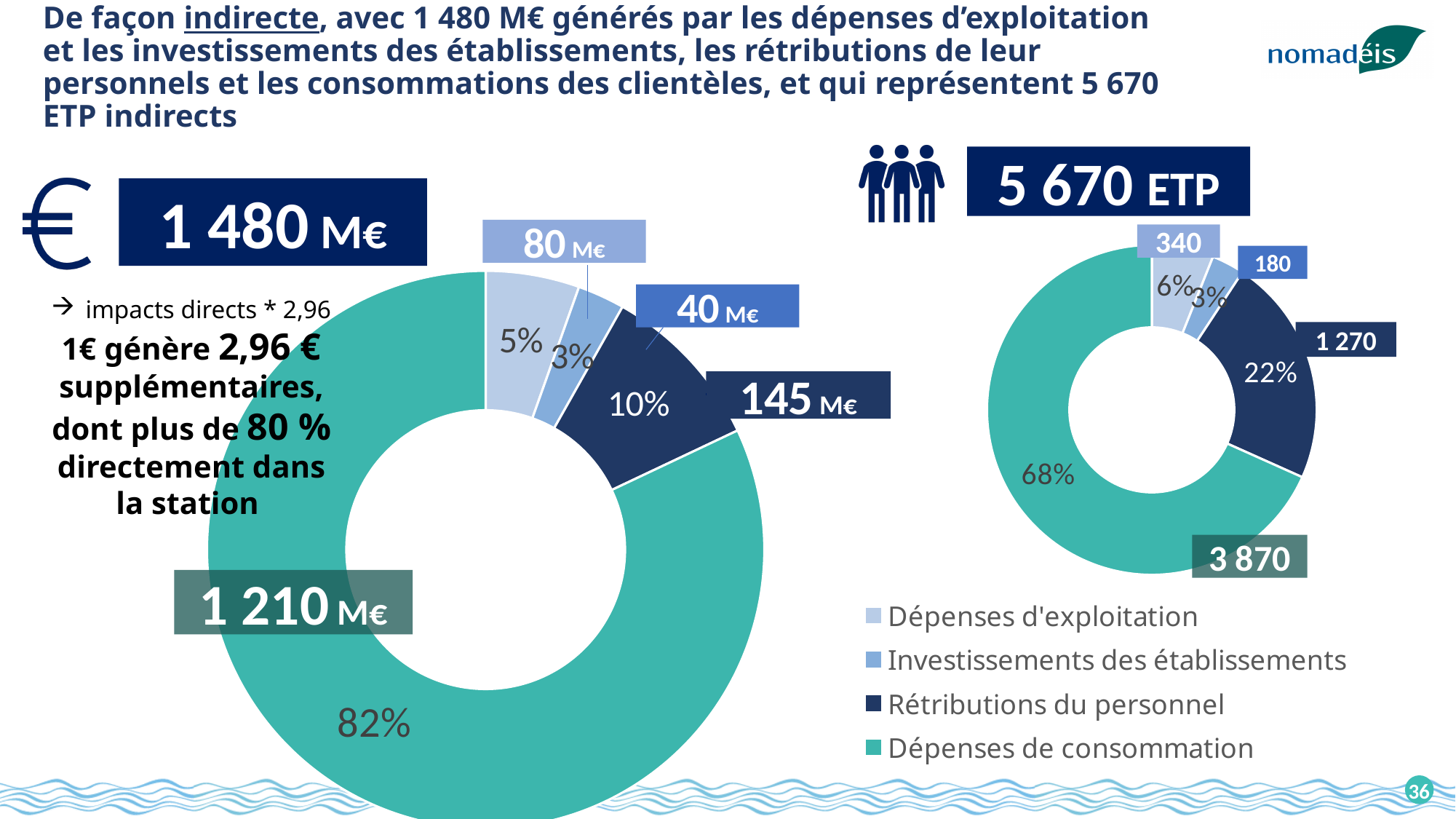
How many categories does the legend list for the donut charts? 4 In the right donut chart (5 670 ETP), which is larger: Investissements des établissements or Dépenses d'exploitation? Dépenses d'exploitation In the right donut chart (5 670 ETP), which category has the largest value? Dépenses de consommation In the left donut chart (1 480 M€), what is the difference between Rétributions du personnel and Dépenses d'exploitation? 65 M€ In the left donut chart (1 480 M€), what is the value for Rétributions du personnel? 145 M€ In the left donut chart (1 480 M€), which category has the smallest value? Investissements des établissements In the left donut chart (1 480 M€), what is the value for Dépenses de consommation? 1 210 M€ In the right donut chart (5 670 ETP), what percentage share is shown for Dépenses de consommation? 68% In the right donut chart (5 670 ETP), what is the value for Rétributions du personnel? 1 270 In the right donut chart (5 670 ETP), what is the value for Dépenses d'exploitation? 340 In the left donut chart (1 480 M€), what percentage share is shown for Dépenses d'exploitation? 5% What type of chart is used on this slide? Donut (pie) chart